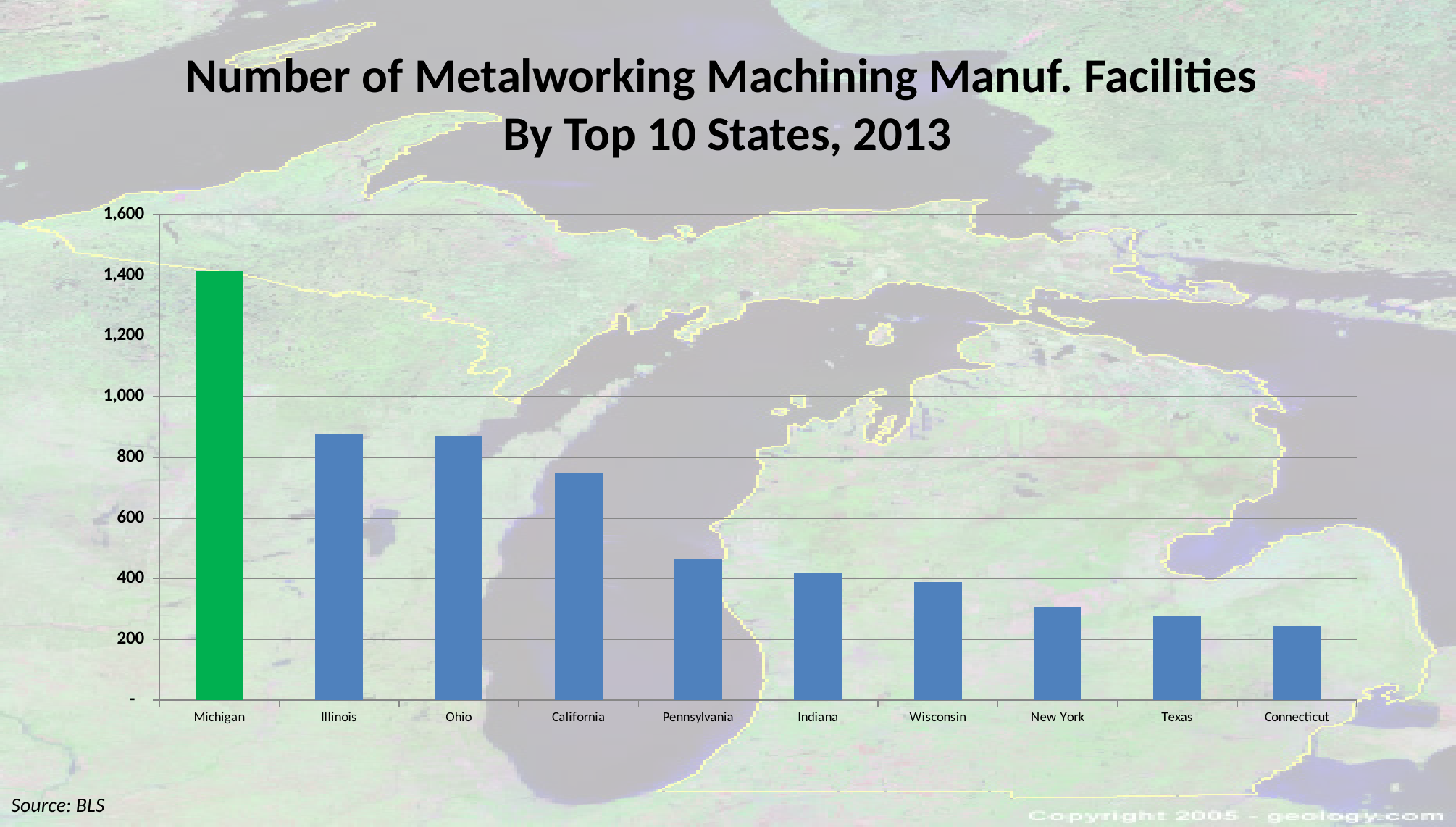
Which state has the lowest number of metalworking machining manufacturing facilities? Connecticut Which has more facilities, California or Indiana? California Do the values rise or fall moving from left to right across the states? Fall Is the value for Texas greater or less than 200? greater Is the value for Illinois greater or less than 1,000? less Which state's bar is coloured green rather than blue? Michigan How many states are shown on the chart? 10 Is the value for California greater or less than 600? greater Which state has the highest number of metalworking machining manufacturing facilities? Michigan What type of chart is shown on the slide? Bar chart